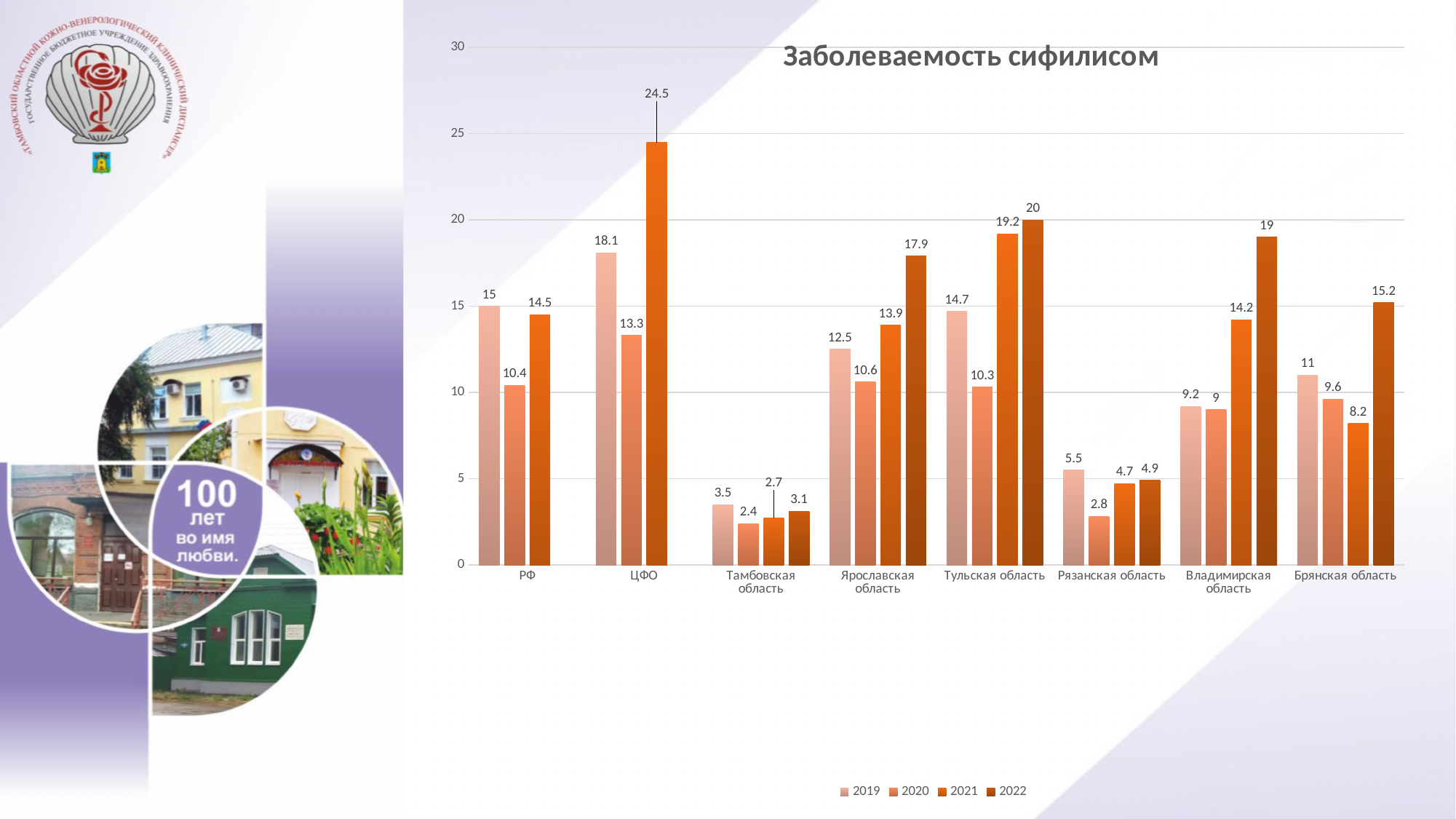
How many series does the legend list? 4 Which category has the lowest 2022 value? Тамбовская область How many categories are shown on the x axis? 8 Do the values for Тульская область rise or fall from 2020 to 2022? rise What is the difference between the 2022 and 2019 values for Владимирская область? 9.8 What is the value for Тамбовская область in 2020? 2.4 Which category has the highest 2021 value? ЦФО What is the title of the chart? Заболеваемость сифилисом What kind of chart is shown on the slide? bar chart Which is larger: the 2022 value for Тульская область or the 2022 value for Ярославская область? Тульская область What is the value for ЦФО in 2021? 24.5 What is the value for Брянская область in 2022? 15.2